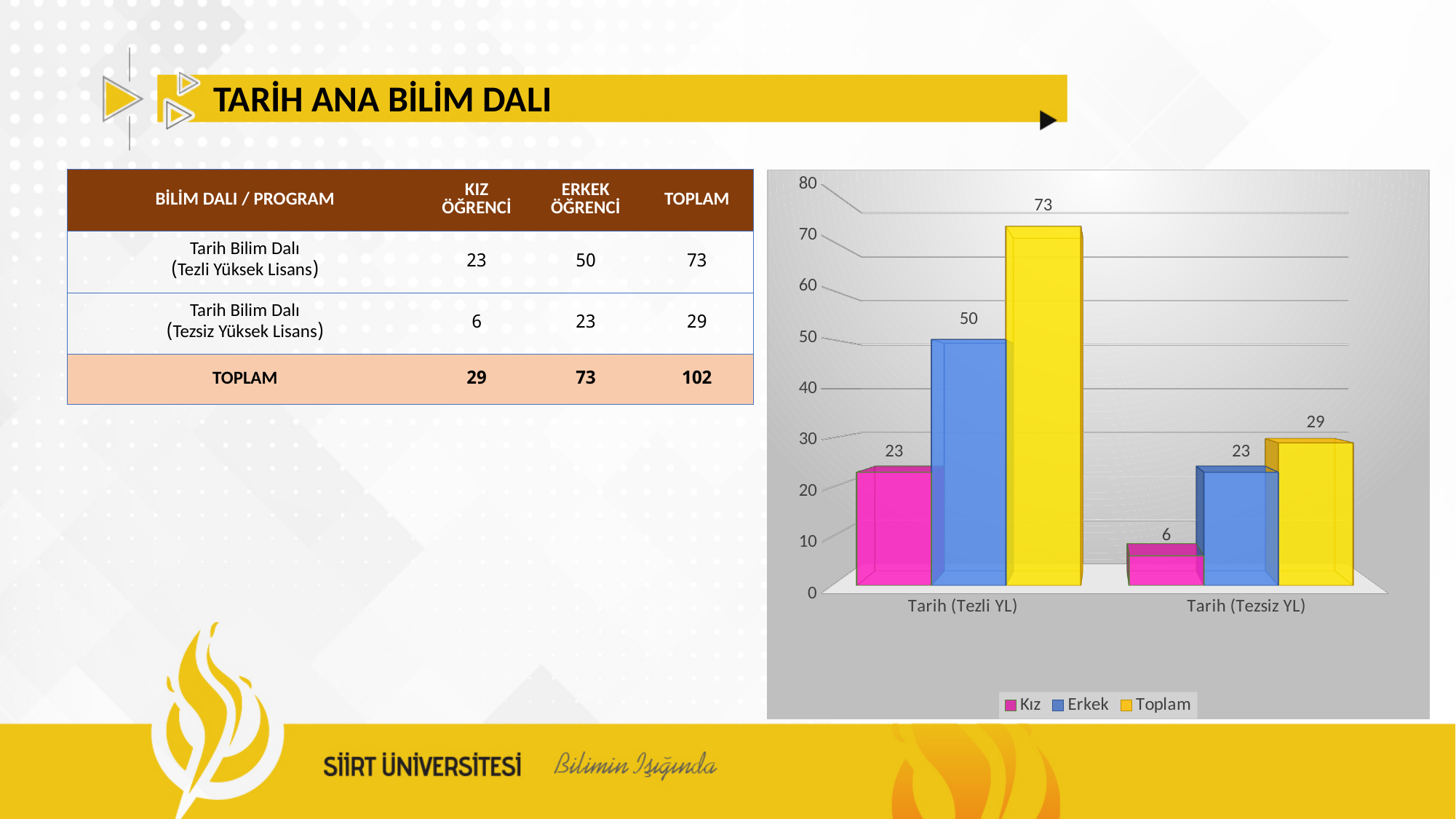
What colour represents the Toplam series in the chart? Yellow How many categories are shown on the x axis? 2 Which is larger: the Erkek value for Tarih (Tezli YL) or the Toplam value for Tarih (Tezsiz YL)? Erkek value for Tarih (Tezli YL) Which category has the highest Toplam value? Tarih (Tezli YL) How many series does the legend list? 3 What is the difference between the Erkek values for Tarih (Tezli YL) and Tarih (Tezsiz YL)? 27 What is the value of the Erkek series for Tarih (Tezsiz YL)? 23 What is the value of the Kız series for Tarih (Tezli YL)? 23 What is the value of the Kız series for Tarih (Tezsiz YL)? 6 Which category has the lowest Kız value? Tarih (Tezsiz YL) What kind of chart is shown on the slide? Bar chart What is the value of the Toplam series for Tarih (Tezli YL)? 73